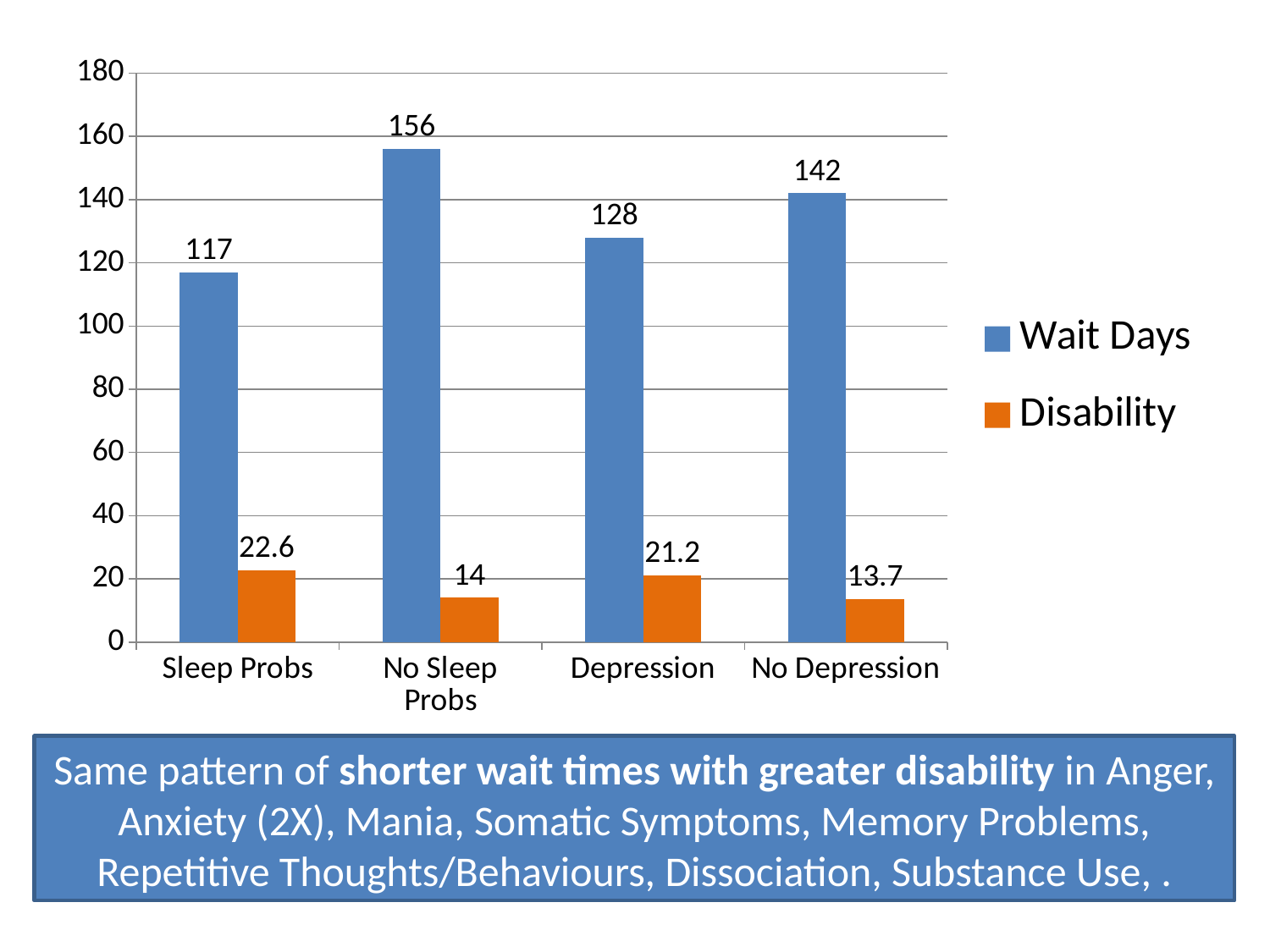
What is the Disability value for Depression? 21.2 What is the difference in Wait Days between No Sleep Probs and Sleep Probs? 39 What is the difference in Disability between Sleep Probs and No Sleep Probs? 8.6 How many categories are shown on the x axis? 4 Is the Wait Days value for No Depression greater or less than 120? greater What is the Wait Days value for Sleep Probs? 117 Which is larger, the Wait Days value for Depression or for No Depression? No Depression Which category has the highest Wait Days value? No Sleep Probs What kind of chart is shown on the slide? bar chart How many series does the legend list? 2 Which category has the lowest Disability value? No Depression What is the Disability value for No Depression? 13.7